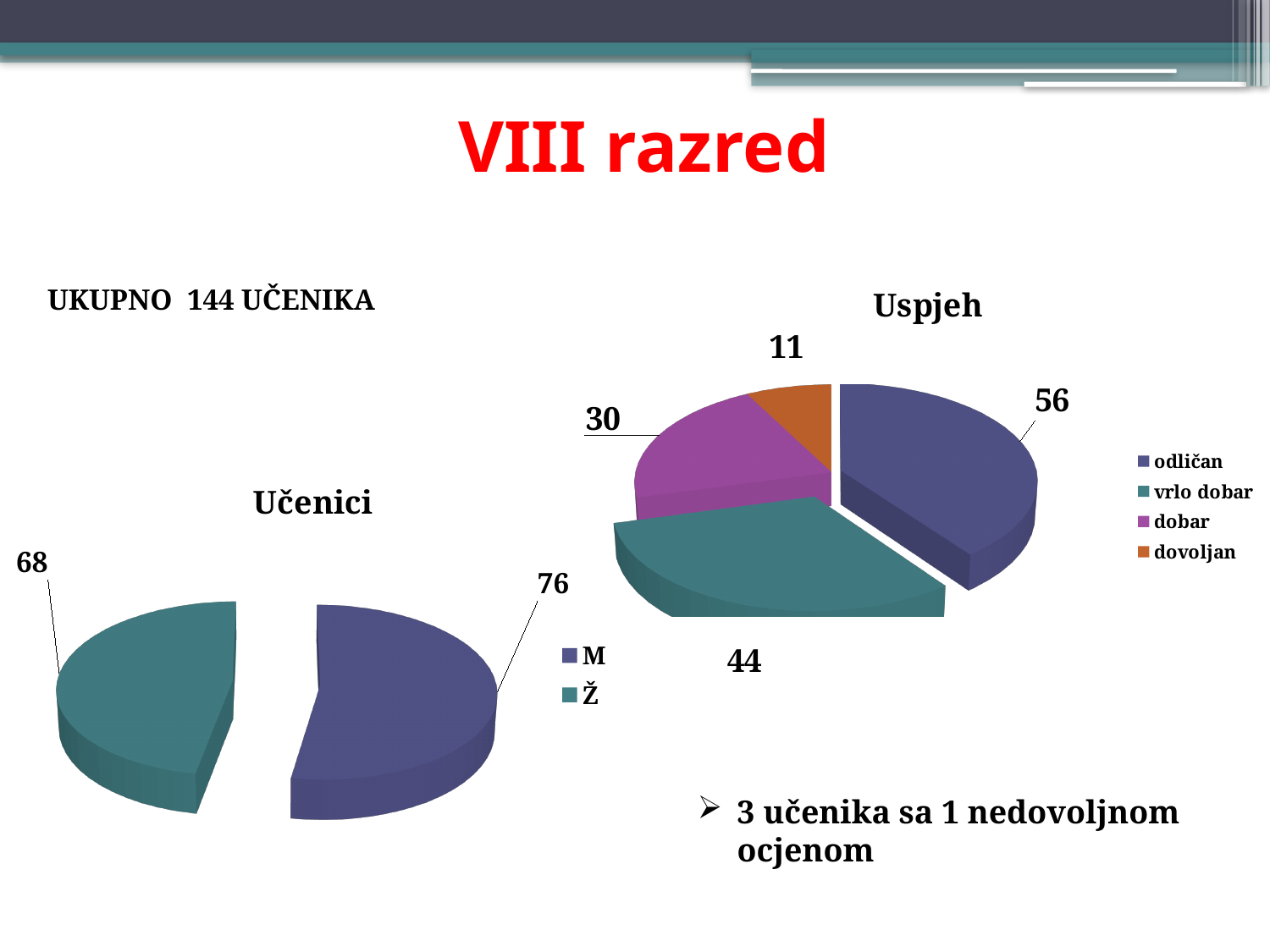
In the 'Uspjeh' chart, what is the value for odličan? 56 What kind of chart is the 'Učenici' chart? pie chart In the 'Uspjeh' chart, what is the difference between the values for odličan and vrlo dobar? 12 In the 'Učenici' chart, what is the difference between the M and Ž values? 8 In the 'Uspjeh' chart, which category has the lowest value? dovoljan In the 'Učenici' chart, what is the value for Ž? 68 In the 'Uspjeh' chart, which category has the highest value? odličan How many categories does the legend of the 'Uspjeh' chart list? 4 In the 'Učenici' chart, which category is larger, M or Ž? M In the 'Učenici' chart, what is the value for M? 76 In the 'Uspjeh' chart, what is the value for dobar? 30 What is the title of the chart on the right side of the slide? Uspjeh